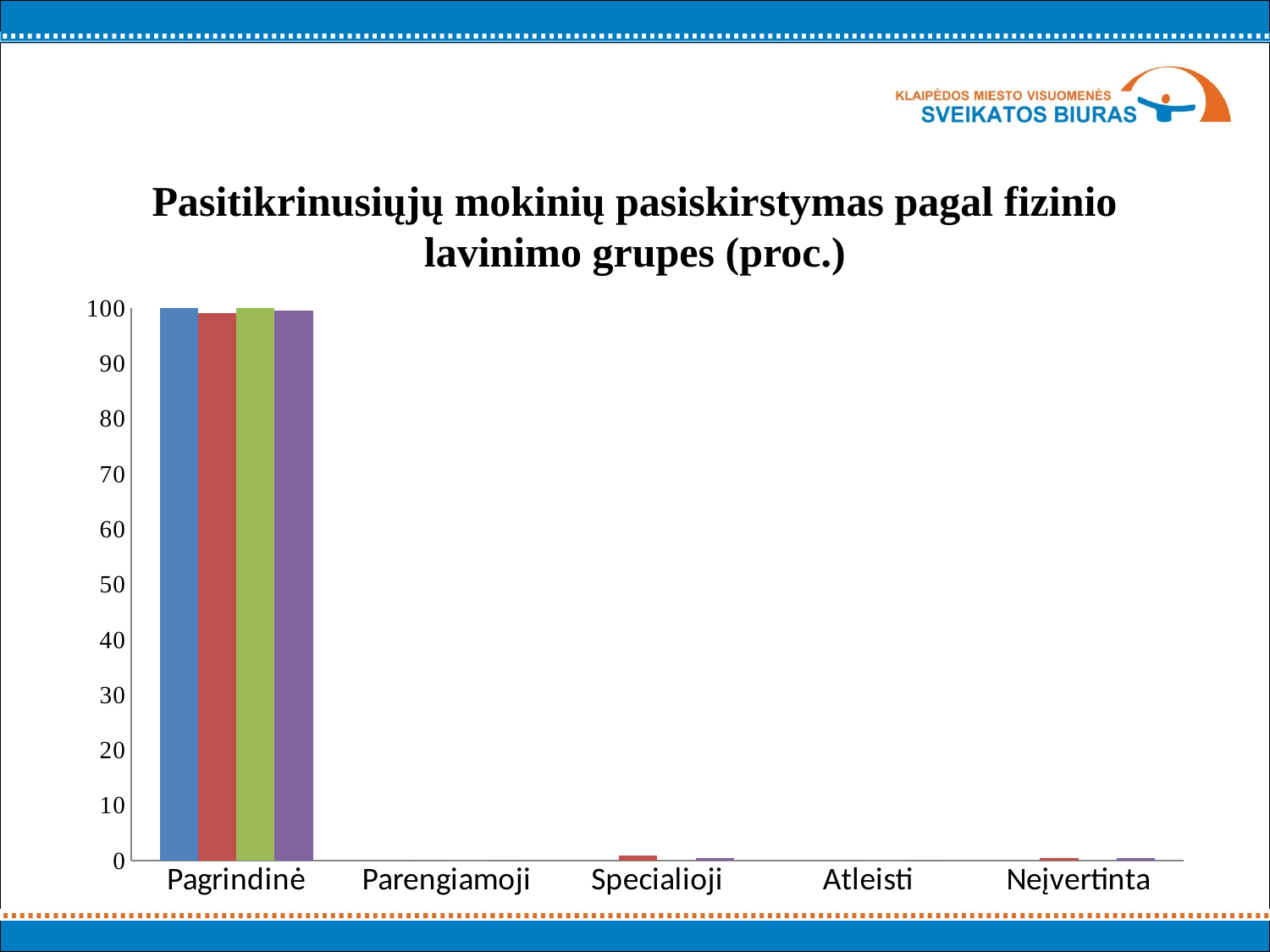
Is the value of the red bar for Specialioji greater or less than 10? less Is the value of the purple bar for Neįvertinta greater or less than 10? less Which category has the highest values in the chart? Pagrindinė What is the title of the chart? Pasitikrinusiųjų mokinių pasiskirstymas pagal fizinio lavinimo grupes (proc.) How many categories are shown on the x axis of the chart? 5 Is the value of the green bar for Pagrindinė greater or less than 50? greater What is the highest value shown on the y axis of the chart? 100 Which category has larger values, Pagrindinė or Neįvertinta? Pagrindinė Which category has larger values, Pagrindinė or Specialioji? Pagrindinė What type of chart is shown on the slide? bar chart